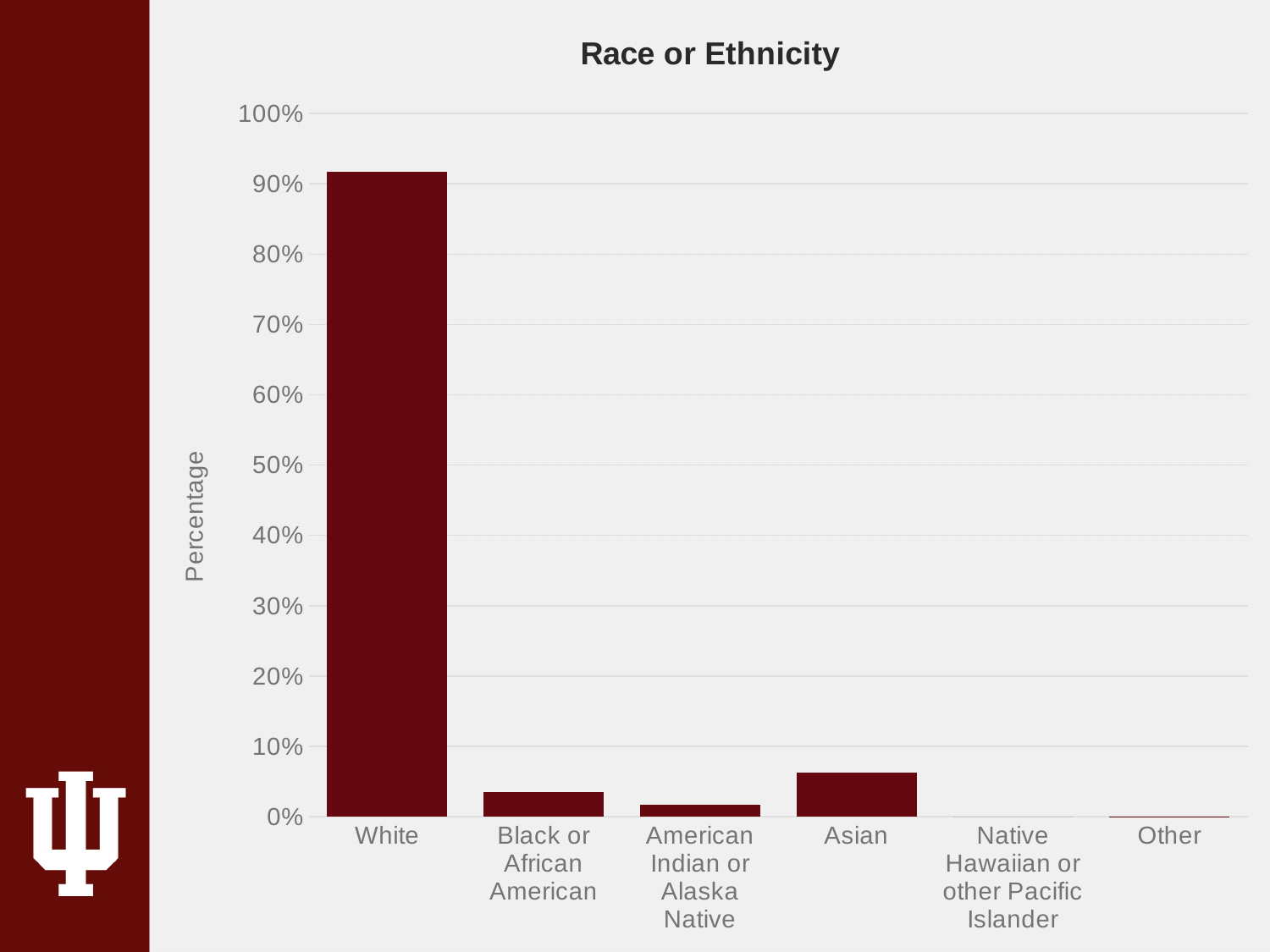
How many race or ethnicity categories are shown on the x axis? 6 Which is larger, the value for Black or African American or the value for American Indian or Alaska Native? Black or African American Is the value for White greater or less than 80%? greater Is the value for Asian greater or less than 10%? less Is the value for White greater or less than 50%? greater What is the label on the vertical axis of the chart? Percentage Which is larger, the value for Asian or the value for Black or African American? Asian What is the title of the chart? Race or Ethnicity What type of chart is shown on the slide? bar chart Which category has the highest percentage? White Which is larger, the value for White or the value for Asian? White